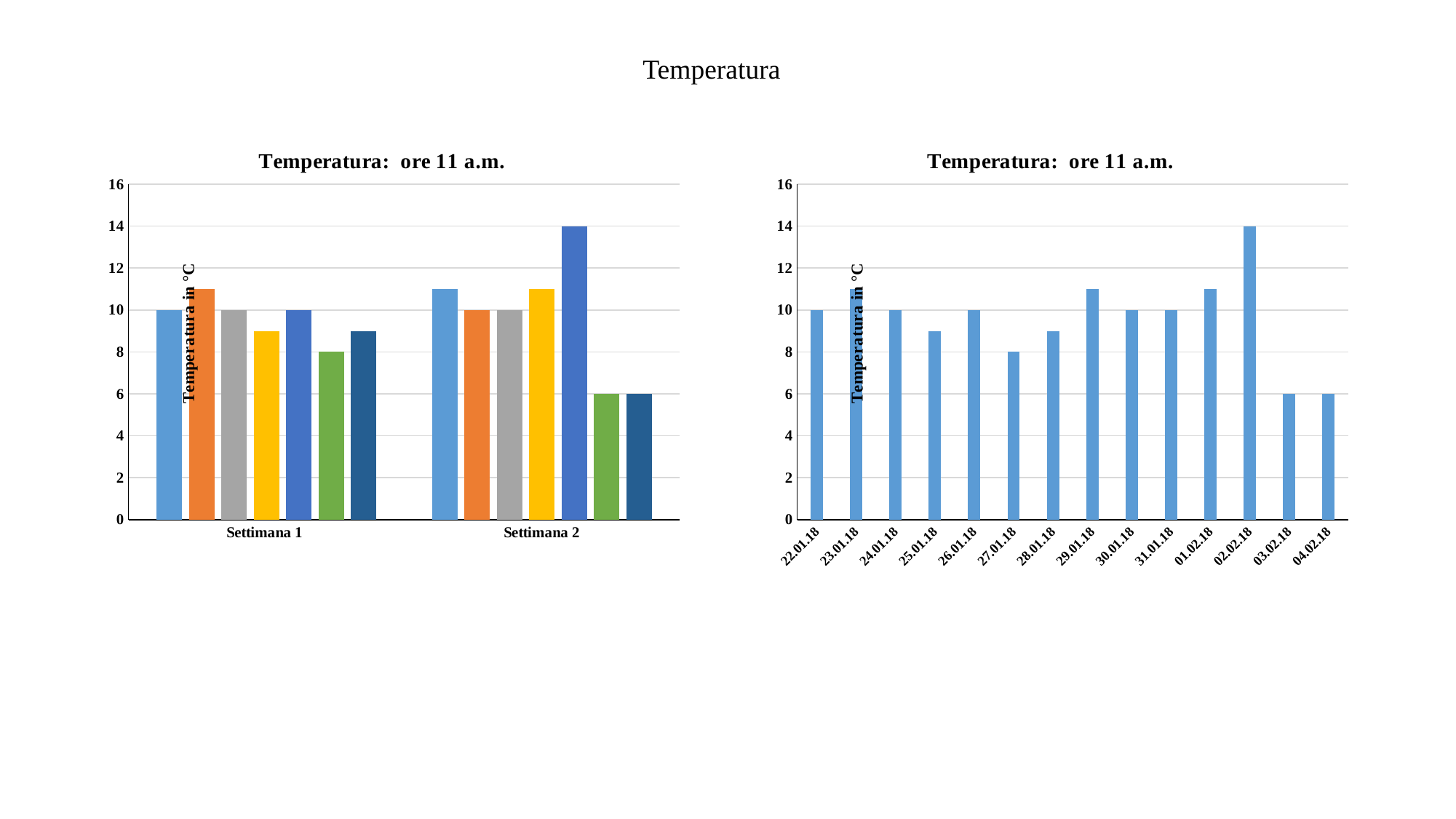
How many categories are shown on the x axis of the chart on the left? 2 What type of chart is the chart on the right side of the slide? bar chart In the chart on the right, what is the difference between the temperature on 02.02.18 and the temperature on 03.02.18? 8 In the chart on the right, which is larger, the value for 02.02.18 or the value for 04.02.18? 02.02.18 In the chart on the right, what is the temperature for 02.02.18? 14 In the chart on the right, is the value for 25.01.18 greater or less than 10? less How many dates are shown on the x axis of the chart on the right? 14 In the chart on the right, what is the temperature for 03.02.18? 6 In the chart on the right, is the value for 23.01.18 greater or less than 10? greater In the chart on the right, what is the temperature for 22.01.18? 10 In the chart on the right, which date has the highest temperature? 02.02.18 In the chart on the right, what is the temperature for 27.01.18? 8